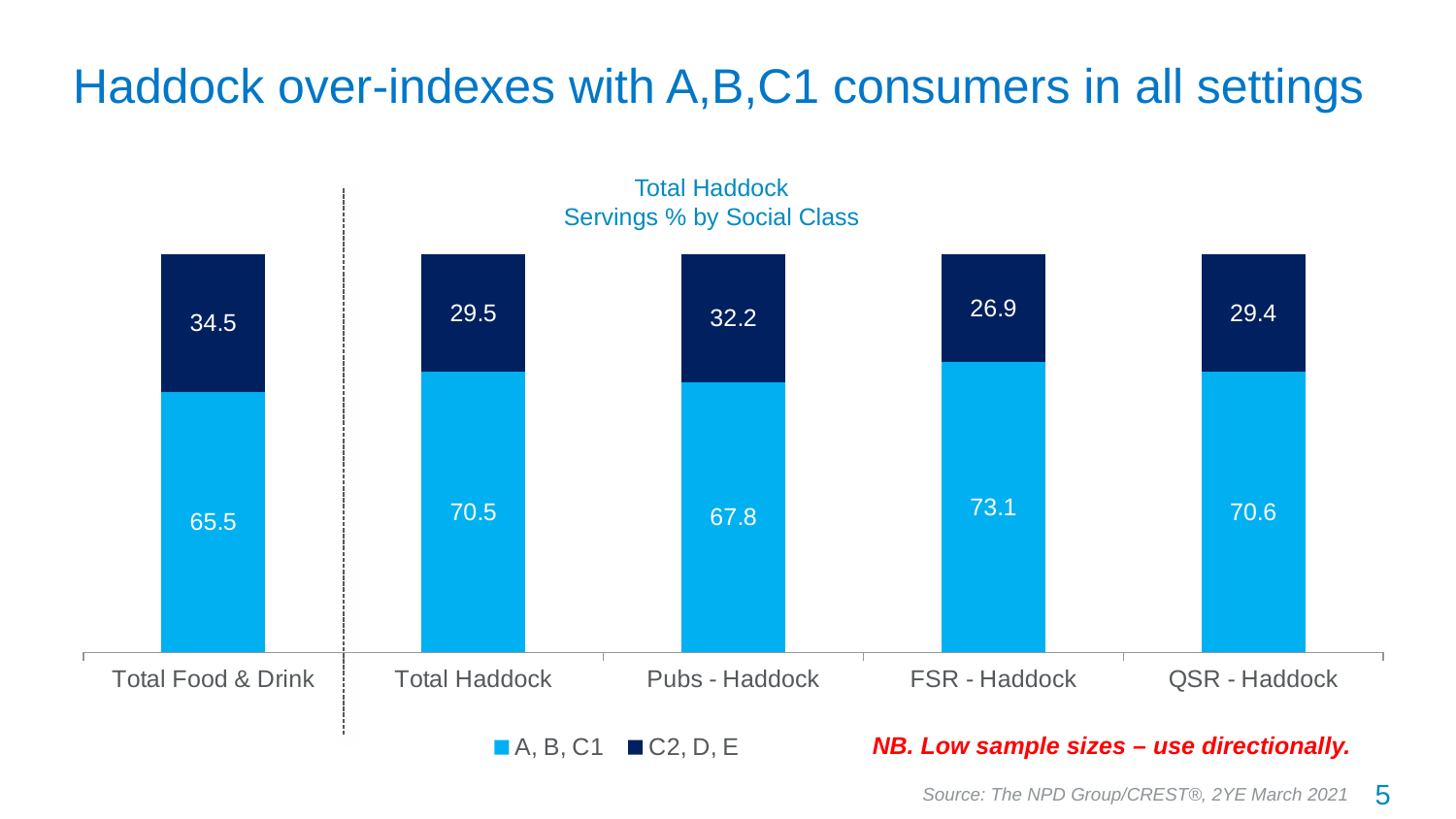
What is the A, B, C1 value for FSR - Haddock? 73.1 Which is larger: the C2, D, E value for Total Food & Drink or for QSR - Haddock? Total Food & Drink Which category has the highest A, B, C1 value? FSR - Haddock What is the difference between the A, B, C1 values for Total Haddock and Total Food & Drink? 5.0 What is the A, B, C1 value for Total Food & Drink? 65.5 How many series does the legend list? 2 What is the C2, D, E value for Pubs - Haddock? 32.2 What kind of chart is shown? Stacked bar chart How many categories are shown on the x axis? 5 Which category has the lowest C2, D, E value? FSR - Haddock What is the title of the chart? Total Haddock Servings % by Social Class What is the total of the stacked bar for Pubs - Haddock? 100.0